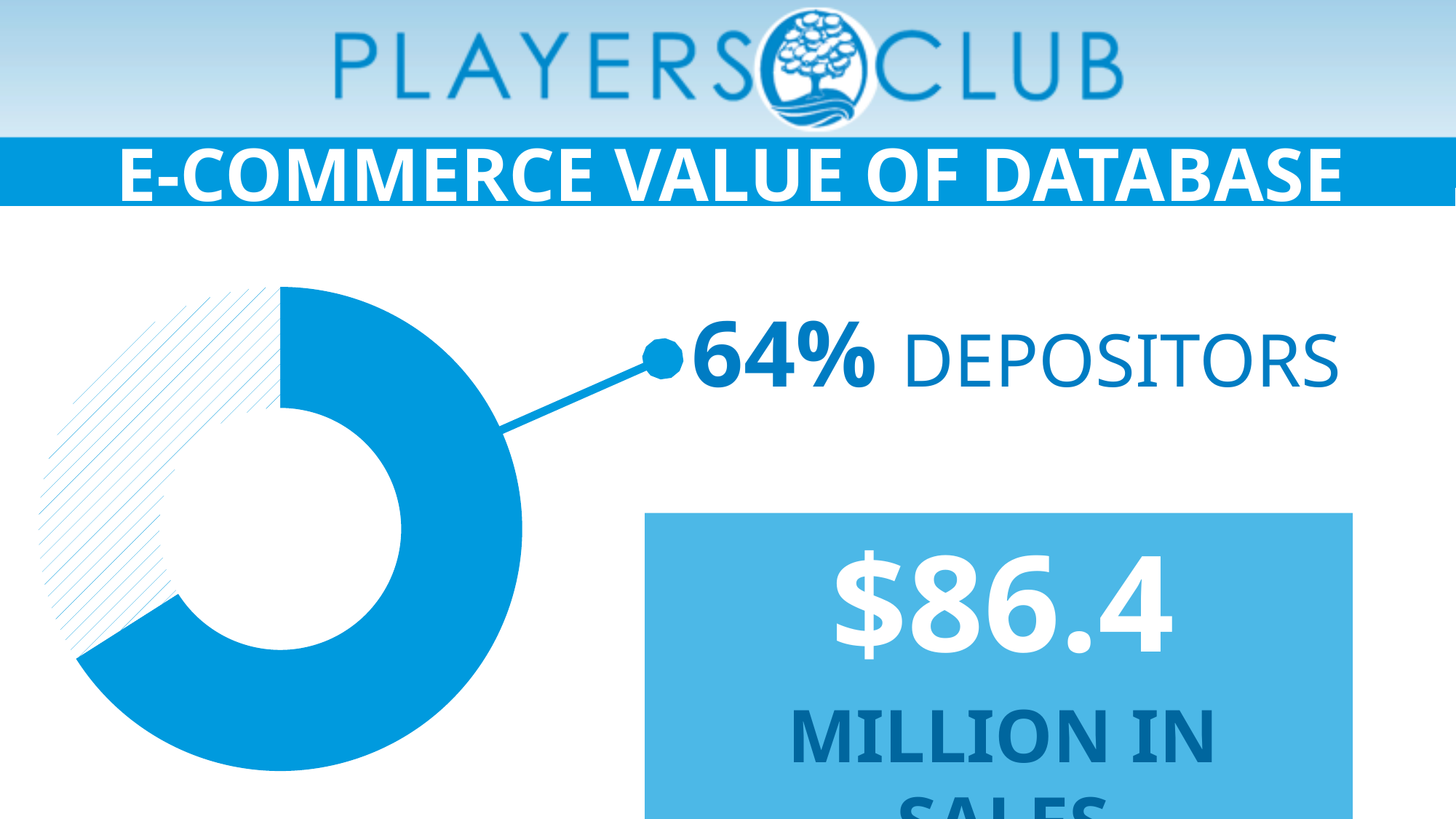
What sales figure is shown in the box next to the donut chart? $86.4 million in sales Is the depositors share in the donut chart greater or less than 50%? greater What is the title of the slide containing the donut chart? E-COMMERCE VALUE OF DATABASE How many segments does the donut chart have? 2 What kind of chart is shown on the slide? Donut (pie) chart What percentage of the database is labelled as depositors in the donut chart? 64% Which segment of the donut chart is larger: the depositors segment or the remaining segment? Depositors